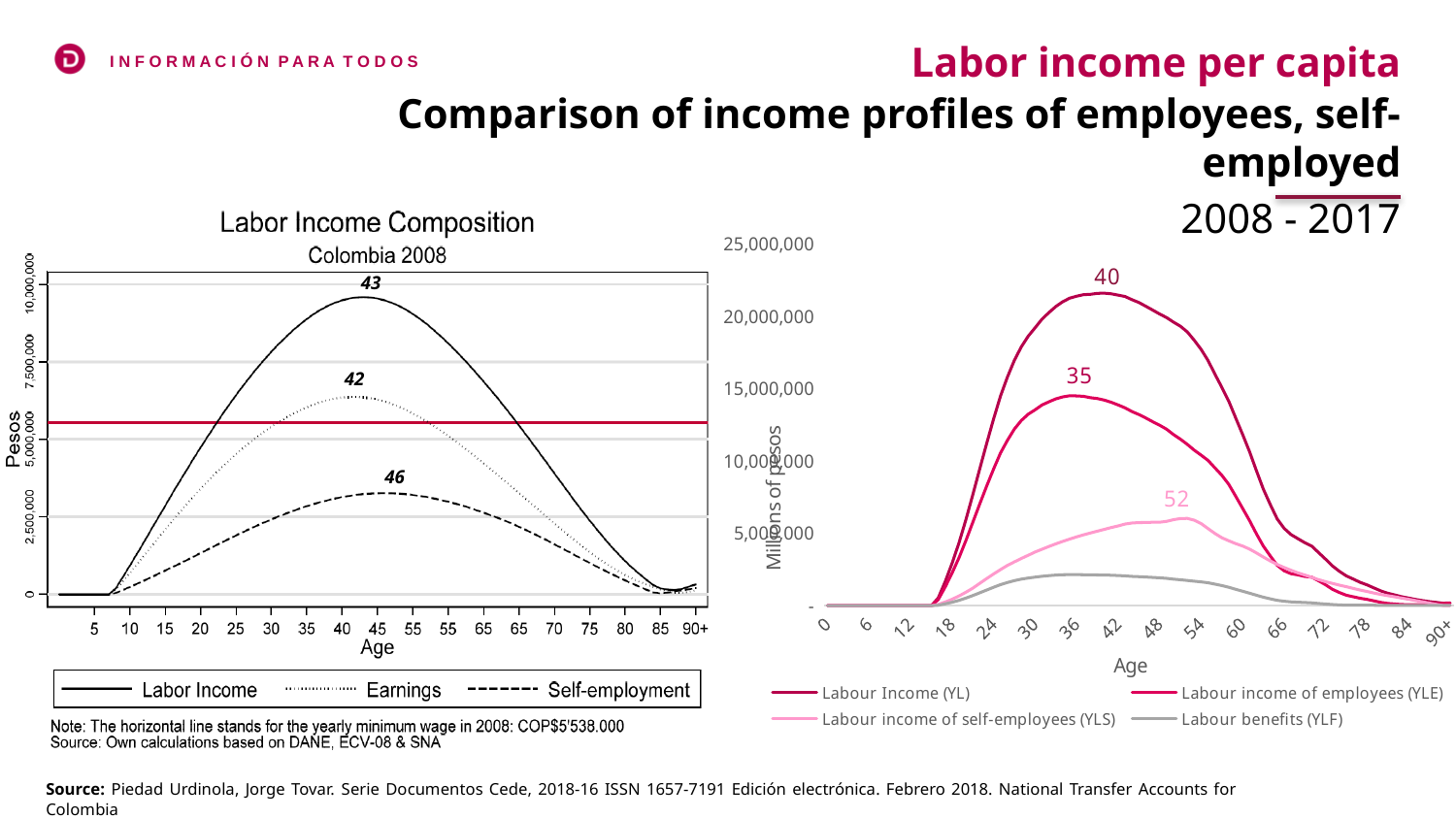
In the right chart, which series has the lowest values across ages? Labour benefits (YLF) In the left chart 'Labor Income Composition Colombia 2008', at what age is the Self-employment curve labelled as peaking? 46 In the left chart 'Labor Income Composition Colombia 2008', at what age is the Labor Income curve labelled as peaking? 43 What kind of chart is the left chart titled 'Labor Income Composition Colombia 2008'? line chart How many series does the legend of the left chart 'Labor Income Composition Colombia 2008' list? 3 In the right chart, at what age is the Labour Income (YL) curve labelled as peaking? 40 In the right chart, at what age is the Labour income of self-employees (YLS) curve labelled as peaking? 52 How many series does the legend of the right chart list? 4 In the right chart, is the peak value of Labour Income (YL) greater or less than 20,000,000? greater In the right chart, is the peak value of Labour income of self-employees (YLS) greater or less than 5,000,000? greater In the left chart 'Labor Income Composition Colombia 2008', is the peak value of Earnings greater or less than 7,500,000? less According to the note under the left chart, what does the horizontal line stand for? The yearly minimum wage in 2008: COP$5'538.000